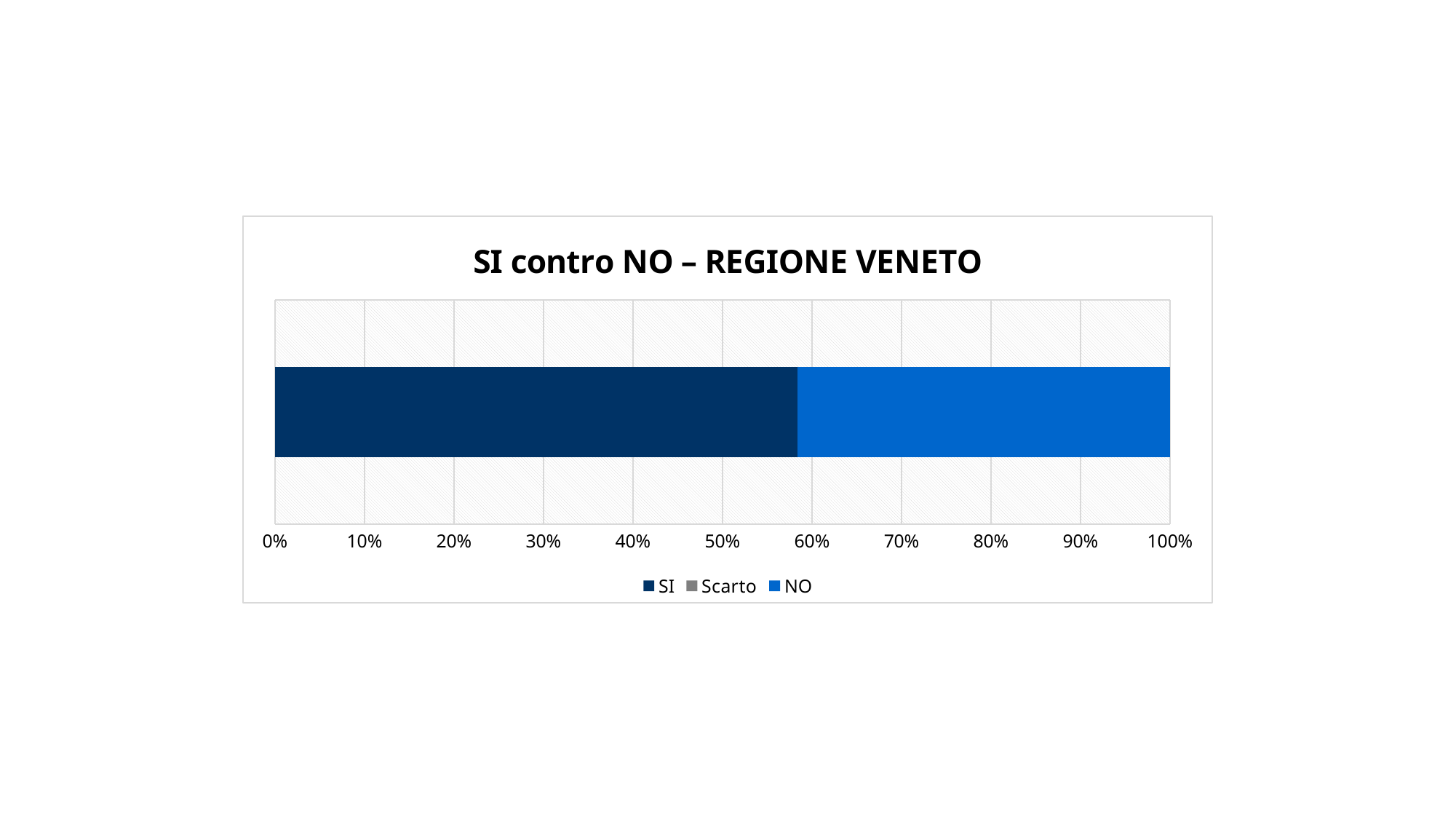
Which series are listed in the legend? SI, Scarto, NO Is the share of the bar taken by NO greater or less than 50%? less How many bars are plotted in the chart? 1 Is the value for SI greater or less than 50%? greater How many series does the legend list? 3 Which is larger, the SI segment or the NO segment? SI Is the share of the bar taken by NO greater or less than 40%? greater What is the highest value shown on the horizontal axis? 100% What kind of chart is shown on the slide? bar chart Which series takes the largest share of the bar? SI What is the title of the chart? SI contro NO – REGIONE VENETO